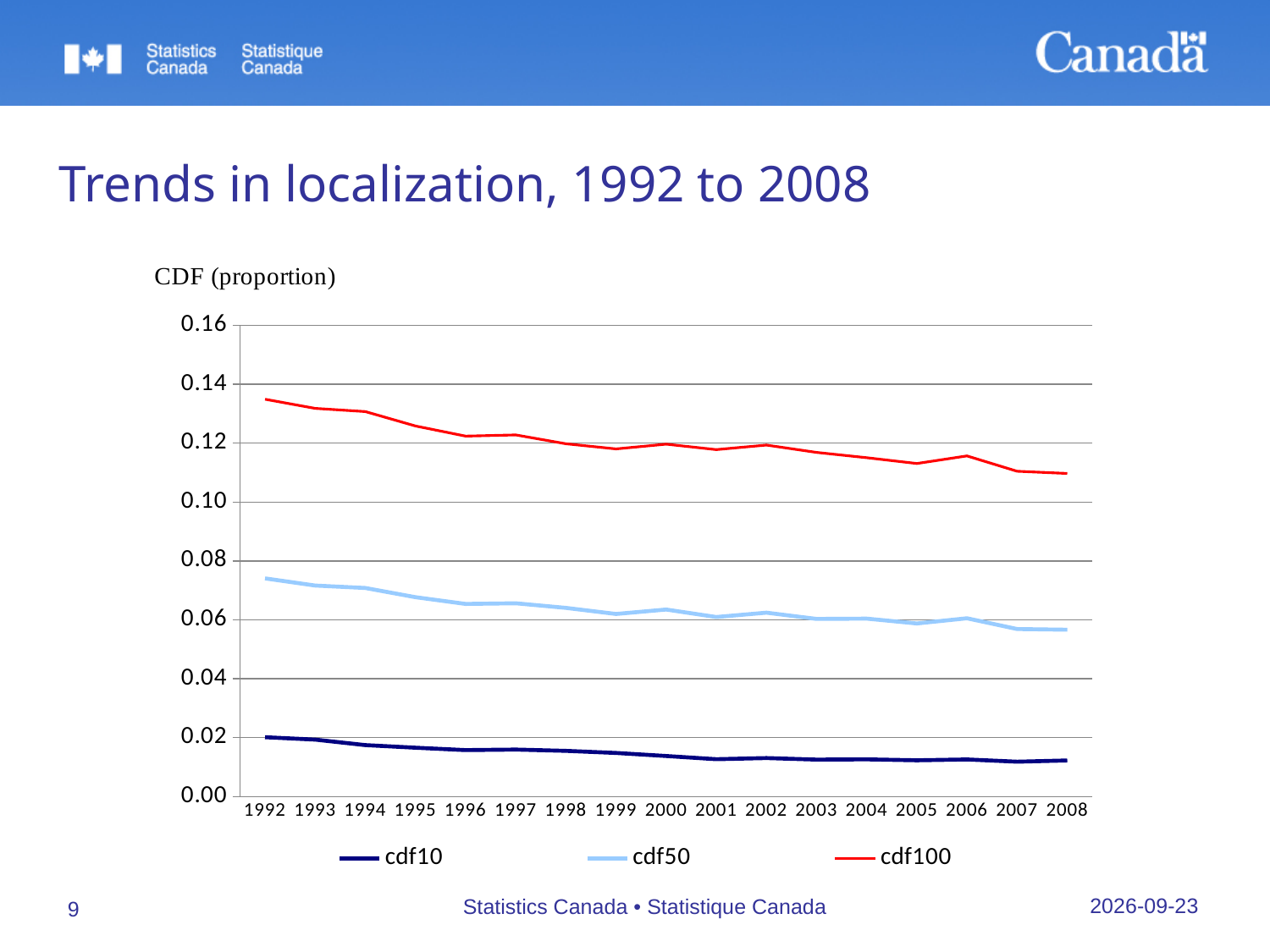
Does the cdf100 line rise or fall from 1992 to 2008? fall Which series has the highest values throughout the chart? cdf100 Which is larger in 2000, cdf100 or cdf50? cdf100 Is the value for cdf100 in 2008 greater or less than 0.12? less Is the value for cdf50 in 1992 greater or less than 0.08? less What is the title of the chart on the slide? Trends in localization, 1992 to 2008 Is the value for cdf100 in 1992 greater or less than 0.12? greater How many series does the legend list? 3 Does the cdf50 line rise or fall from 1992 to 2008? fall What kind of chart is shown on the slide? line chart How many years are plotted along the x axis? 17 Which series has the lowest values throughout the chart? cdf10